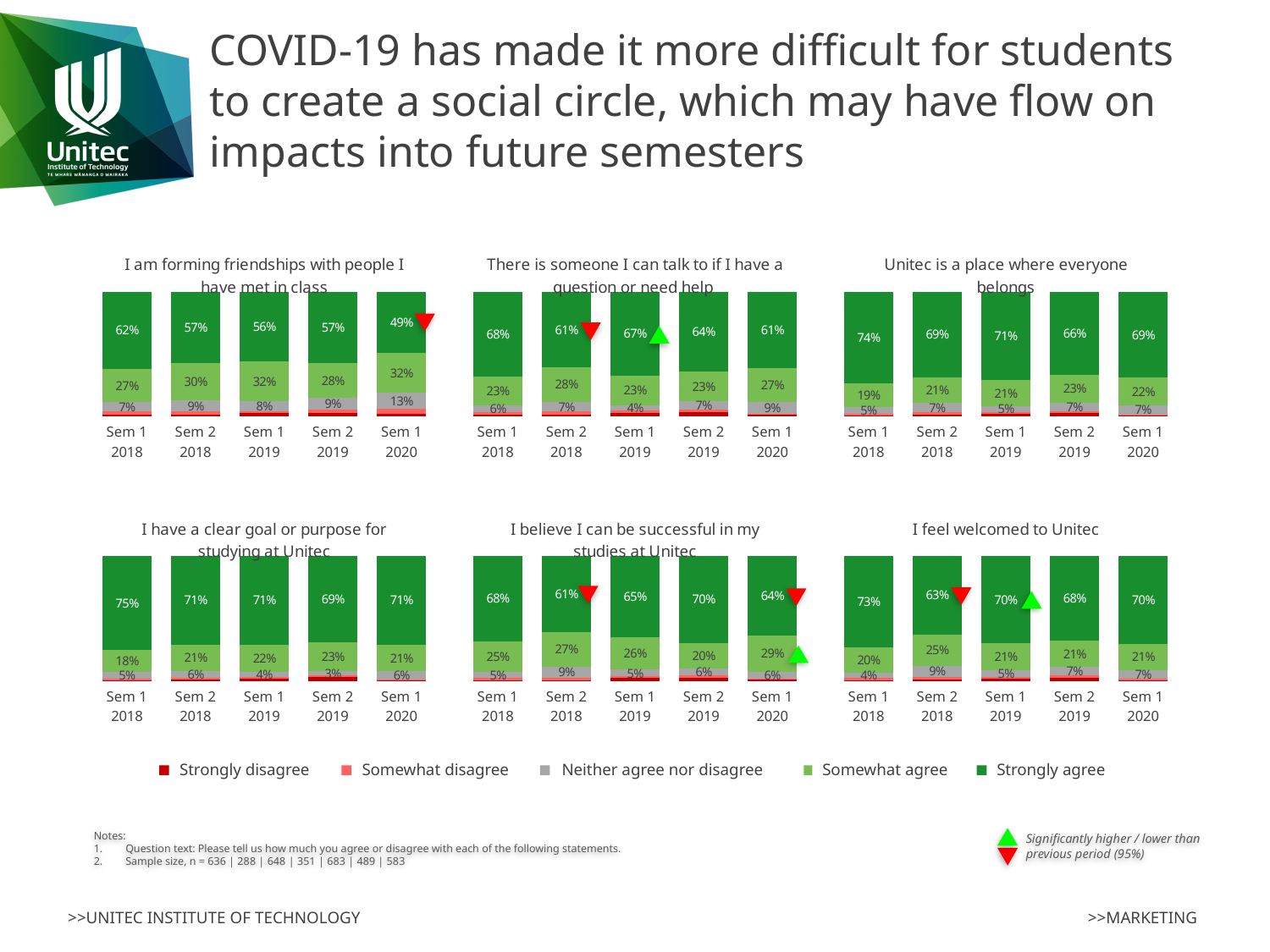
What kind of chart is the chart titled "Unitec is a place where everyone belongs"? Stacked bar chart In the chart titled "I am forming friendships with people I have met in class", what is the Strongly agree value for Sem 1 2020? 49% In the chart titled "There is someone I can talk to if I have a question or need help", what is the difference between the Strongly agree values for Sem 1 2018 and Sem 1 2020? 7% How many semesters are shown on the x axis of the chart titled "I feel welcomed to Unitec"? 5 In the chart titled "Unitec is a place where everyone belongs", what is the Strongly agree value for Sem 1 2018? 74% In the chart titled "I am forming friendships with people I have met in class", which is larger: the Strongly agree value for Sem 1 2018 or for Sem 1 2020? Sem 1 2018 How many series does the legend list? 5 In the chart titled "I am forming friendships with people I have met in class", does the Strongly agree value rise or fall from Sem 1 2018 to Sem 1 2020? Fall Which legend entry is shown in dark green? Strongly agree In the chart titled "I have a clear goal or purpose for studying at Unitec", which semester has the highest Strongly agree value? Sem 1 2018 In the chart titled "I feel welcomed to Unitec", what is the Somewhat agree value for Sem 2 2018? 25% In the chart titled "I believe I can be successful in my studies at Unitec", which semester has the lowest Strongly agree value? Sem 2 2018